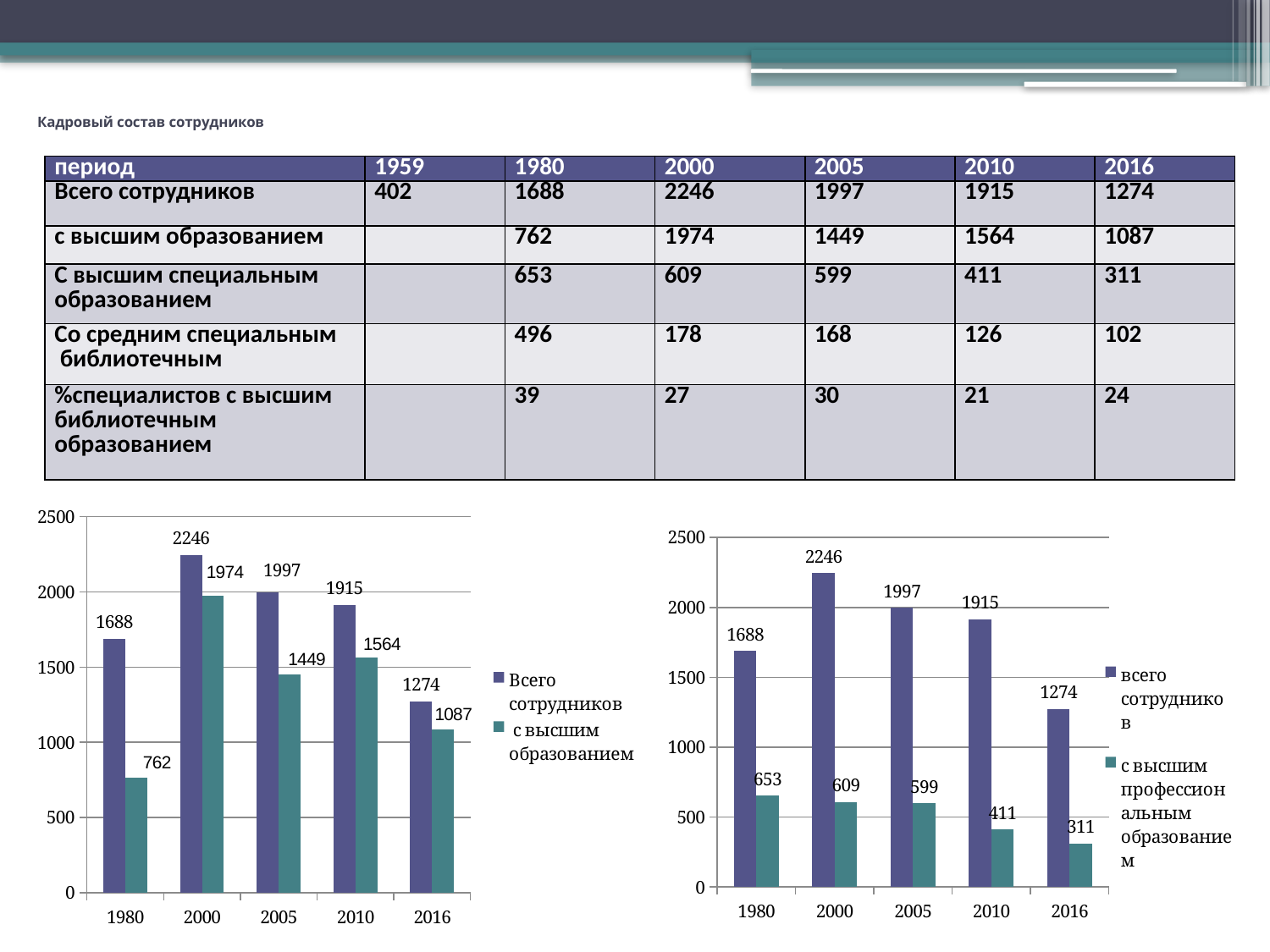
In the right chart, which year has the lowest value for 'с высшим профессиональным образованием'? 2016 How many years are shown on the x axis of the left chart? 5 In the left chart, what is the value for 'с высшим образованием' in 2005? 1449 In the left chart, which year has the highest value for 'Всего сотрудников'? 2000 In the right chart, what is the difference between 'всего сотрудников' and 'с высшим профессиональным образованием' in 2016? 963 In the right chart, what is the value for 'с высшим профессиональным образованием' in 2010? 411 In the right chart, does the value for 'с высшим профессиональным образованием' rise or fall from 1980 to 2016? fall In the right chart, is the value for 'с высшим профессиональным образованием' in 1980 greater or less than 500? greater What type of chart is the left chart? bar chart How many series does the legend of the right chart list? 2 In the left chart, what is the difference between 'Всего сотрудников' and 'с высшим образованием' in 1980? 926 In the left chart, which is larger: 'с высшим образованием' in 2000 or in 2010? 2000